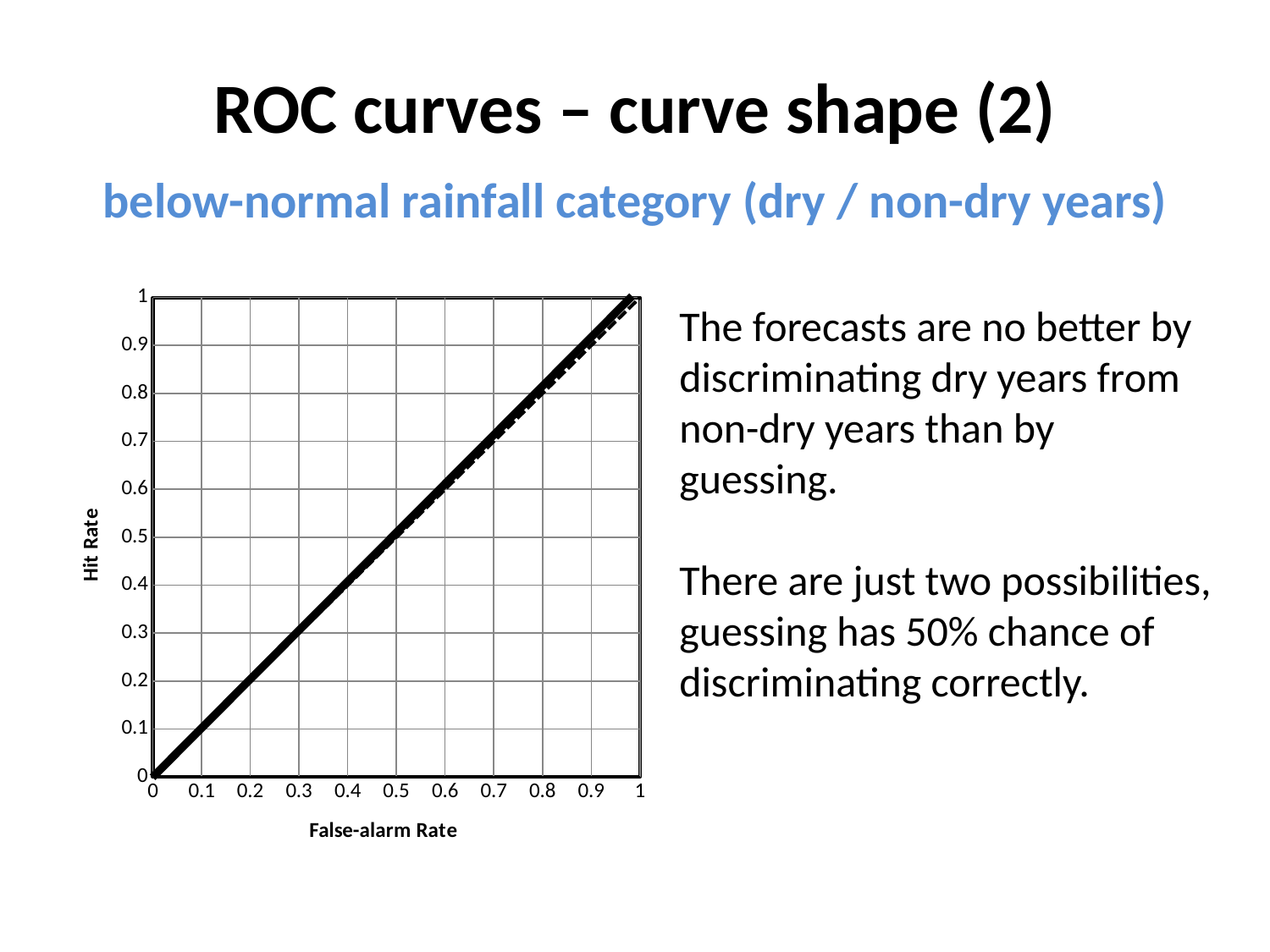
Is the hit rate at a false-alarm rate of 0.9 greater or less than 0.7? greater What is the highest value shown on the x axis of the chart? 1 What kind of chart is shown on the slide? line chart Is the hit rate at a false-alarm rate of 0.1 greater or less than 0.3? less Is the hit rate at a false-alarm rate of 0.8 greater or less than 0.5? greater Does the hit rate rise or fall as the false-alarm rate increases along the x axis? rise What is the hit rate when the false-alarm rate is 1? 1 What is the title of the y axis of the chart? Hit Rate Which is larger: the hit rate at a false-alarm rate of 0.3 or at a false-alarm rate of 0.7? 0.7 What is the title of the x axis of the chart? False-alarm Rate What is the hit rate when the false-alarm rate is 0? 0